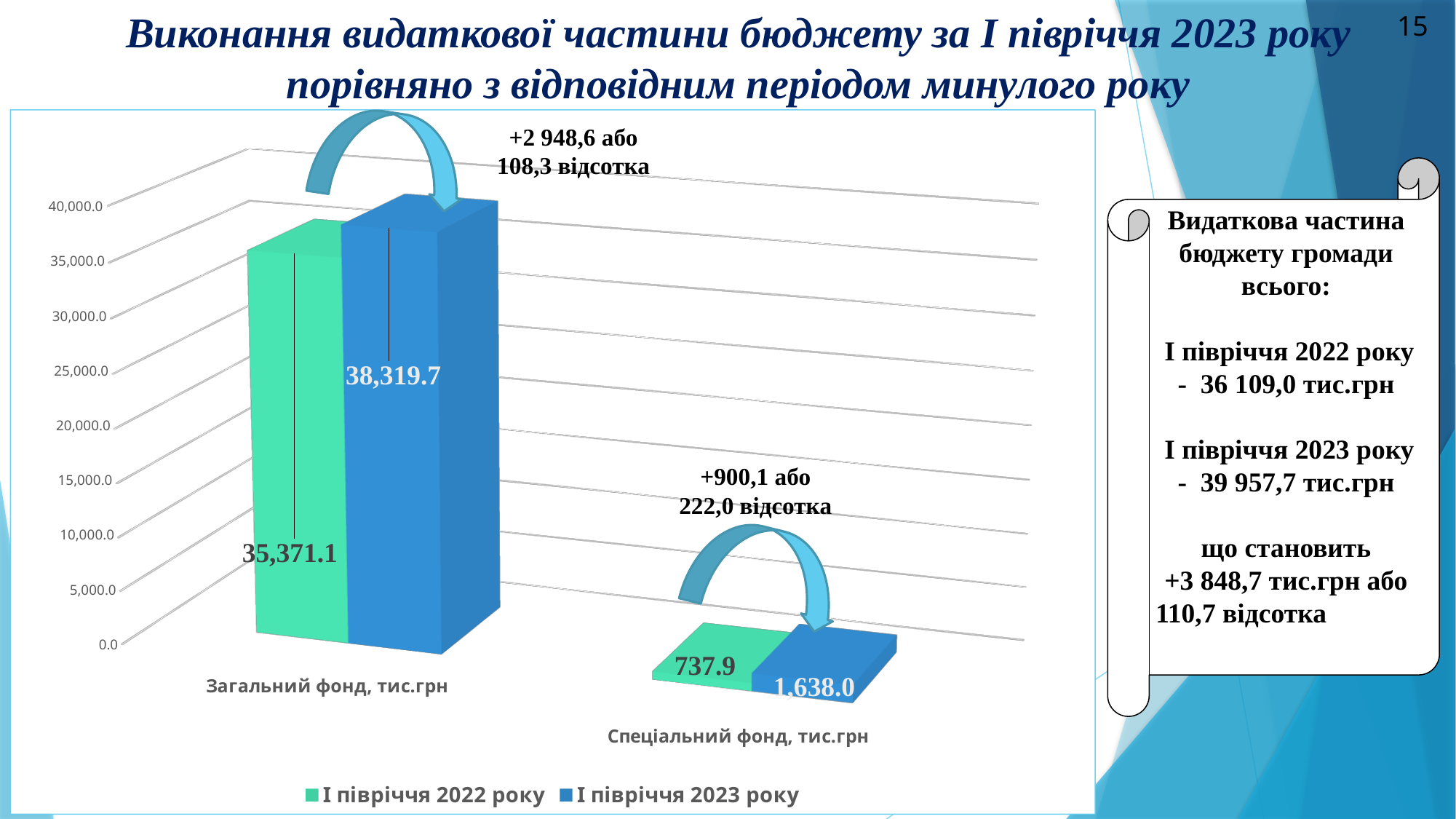
What is the difference between the "І півріччя 2023 року" and "І півріччя 2022 року" values for "Загальний фонд, тис.грн"? 2,948.6 Which category has the lowest value for "І півріччя 2022 року"? Спеціальний фонд, тис.грн What is the value for "І півріччя 2022 року" in the "Загальний фонд, тис.грн" category? 35,371.1 How many series does the legend list? 2 Which colour represents the "І півріччя 2023 року" series in the legend? blue What is the value for "І півріччя 2023 року" in the "Спеціальний фонд, тис.грн" category? 1,638.0 What is the value for "І півріччя 2023 року" in the "Загальний фонд, тис.грн" category? 38,319.7 What is the difference between the "І півріччя 2023 року" and "І півріччя 2022 року" values for "Спеціальний фонд, тис.грн"? 900.1 Which is larger for "Спеціальний фонд, тис.грн": the "І півріччя 2022 року" value or the "І півріччя 2023 року" value? І півріччя 2023 року What type of chart is shown on the slide? bar chart What is the value for "І півріччя 2022 року" in the "Спеціальний фонд, тис.грн" category? 737.9 How many categories are shown on the x axis? 2